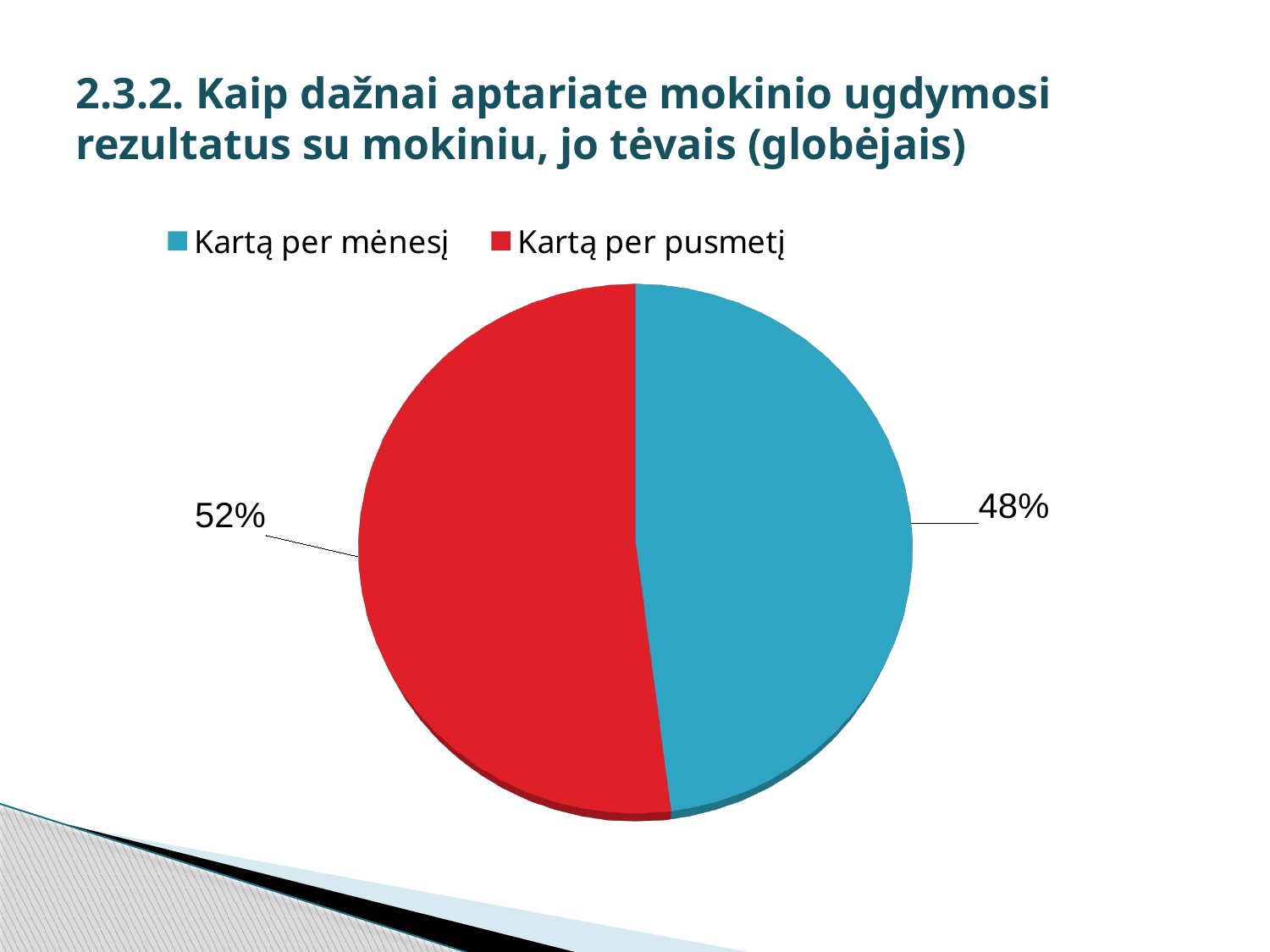
What colour is the "Kartą per pusmetį" slice? red Which category has the largest share of the pie? Kartą per pusmetį What kind of chart is shown on the slide? pie chart What colour is the "Kartą per mėnesį" slice? blue What is the difference in percentage points between the "Kartą per pusmetį" and "Kartą per mėnesį" slices? 4 How many entries does the legend list? 2 What is the total of the two slice percentages shown on the pie chart? 100% Which category has the smallest share of the pie? Kartą per mėnesį Which is larger: the share for "Kartą per mėnesį" or the share for "Kartą per pusmetį"? Kartą per pusmetį What share of the pie is labelled "Kartą per mėnesį"? 48% What share of the pie is labelled "Kartą per pusmetį"? 52% How many slices does the pie chart have? 2